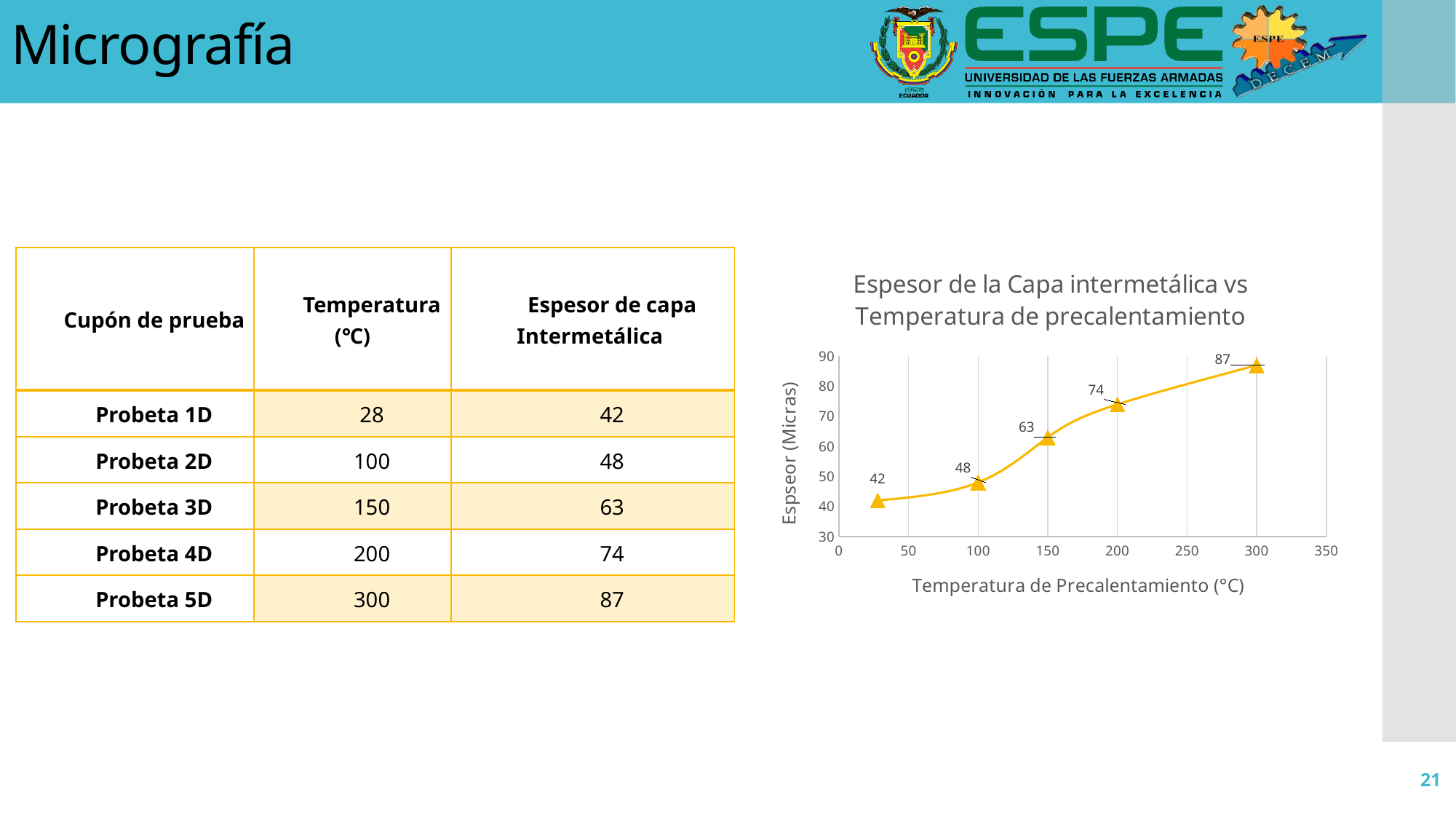
What is the thickness value (Micras) at a preheating temperature of 100 °C? 48 What is the lowest thickness value plotted on the chart? 42 What type of chart is shown on the slide? Line chart Does the thickness rise or fall as the preheating temperature increases? Rises What is the thickness value (Micras) at a preheating temperature of 300 °C? 87 Which has a larger thickness value: the point at 100 °C or the point at 150 °C? 150 °C At which preheating temperature is the intermetallic layer thickness highest? 300 What is the title of the chart? Espesor de la Capa intermetálica vs Temperatura de precalentamiento How many data points are plotted on the chart? 5 What is the difference in thickness between the points at 300 °C and 200 °C? 13 What is the thickness value (Micras) at a preheating temperature of 150 °C? 63 What is the label of the y axis of the chart? Espseor (Micras)